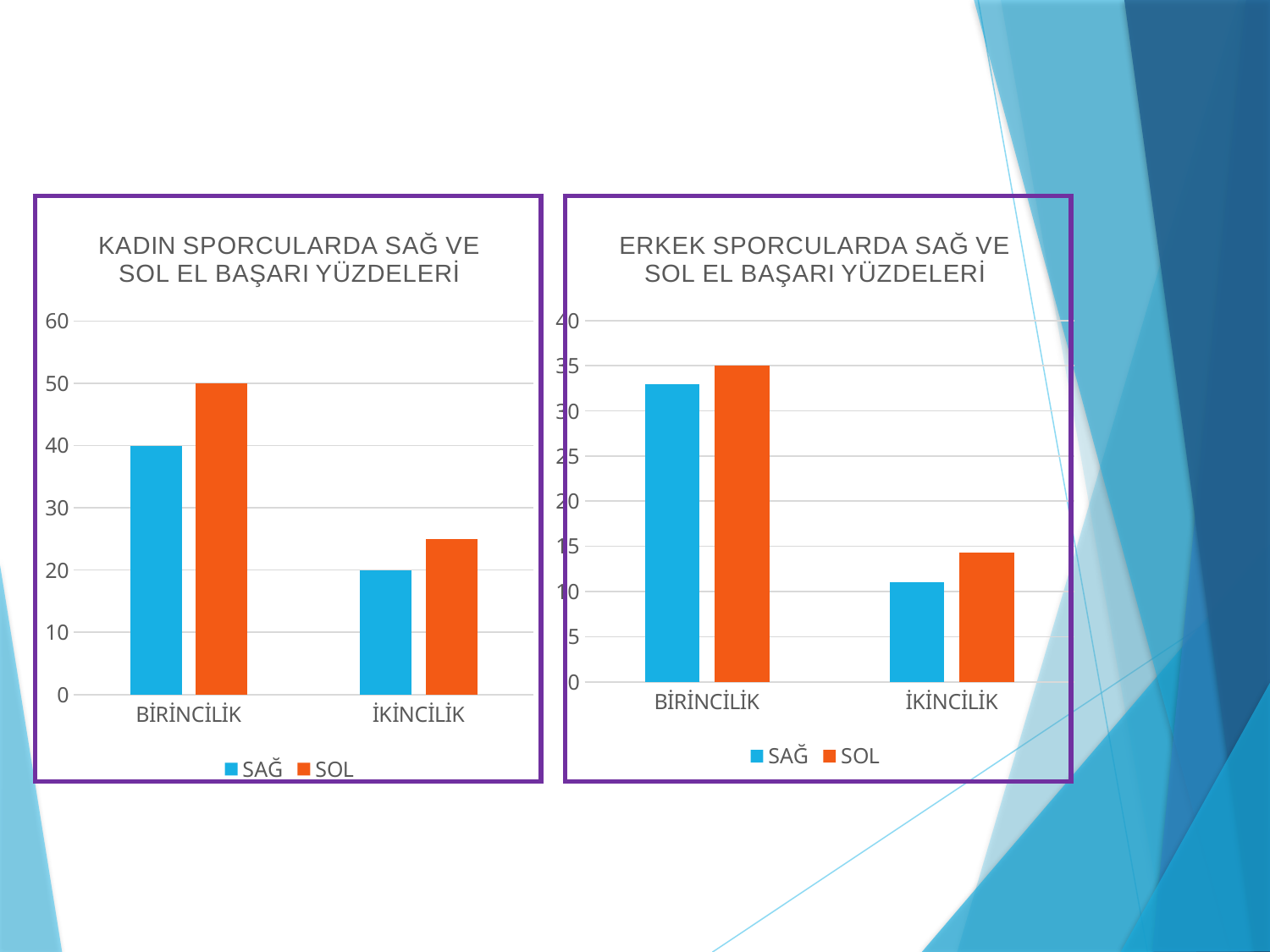
In the chart titled 'KADIN SPORCULARDA SAĞ VE SOL EL BAŞARI YÜZDELERİ', what is the difference between the SOL and SAĞ values for BİRİNCİLİK? 10 In the chart titled 'KADIN SPORCULARDA SAĞ VE SOL EL BAŞARI YÜZDELERİ', what kind of chart is shown? bar chart In the chart titled 'KADIN SPORCULARDA SAĞ VE SOL EL BAŞARI YÜZDELERİ', what is the SAĞ value for BİRİNCİLİK? 40 In the chart titled 'ERKEK SPORCULARDA SAĞ VE SOL EL BAŞARI YÜZDELERİ', how many categories are shown on the x axis? 2 In the chart titled 'ERKEK SPORCULARDA SAĞ VE SOL EL BAŞARI YÜZDELERİ', what is the SOL value for BİRİNCİLİK? 35 In the chart titled 'KADIN SPORCULARDA SAĞ VE SOL EL BAŞARI YÜZDELERİ', how many series does the legend list? 2 In the chart titled 'KADIN SPORCULARDA SAĞ VE SOL EL BAŞARI YÜZDELERİ', what is the SOL value for BİRİNCİLİK? 50 In the chart titled 'ERKEK SPORCULARDA SAĞ VE SOL EL BAŞARI YÜZDELERİ', is the SAĞ value for İKİNCİLİK greater or less than 15? less In the chart titled 'ERKEK SPORCULARDA SAĞ VE SOL EL BAŞARI YÜZDELERİ', is the SAĞ value for BİRİNCİLİK greater or less than 30? greater In the chart titled 'ERKEK SPORCULARDA SAĞ VE SOL EL BAŞARI YÜZDELERİ', which category has the highest SOL value? BİRİNCİLİK In the chart titled 'KADIN SPORCULARDA SAĞ VE SOL EL BAŞARI YÜZDELERİ', what is the SAĞ value for İKİNCİLİK? 20 In the chart titled 'KADIN SPORCULARDA SAĞ VE SOL EL BAŞARI YÜZDELERİ', which series has the larger value for İKİNCİLİK, SAĞ or SOL? SOL